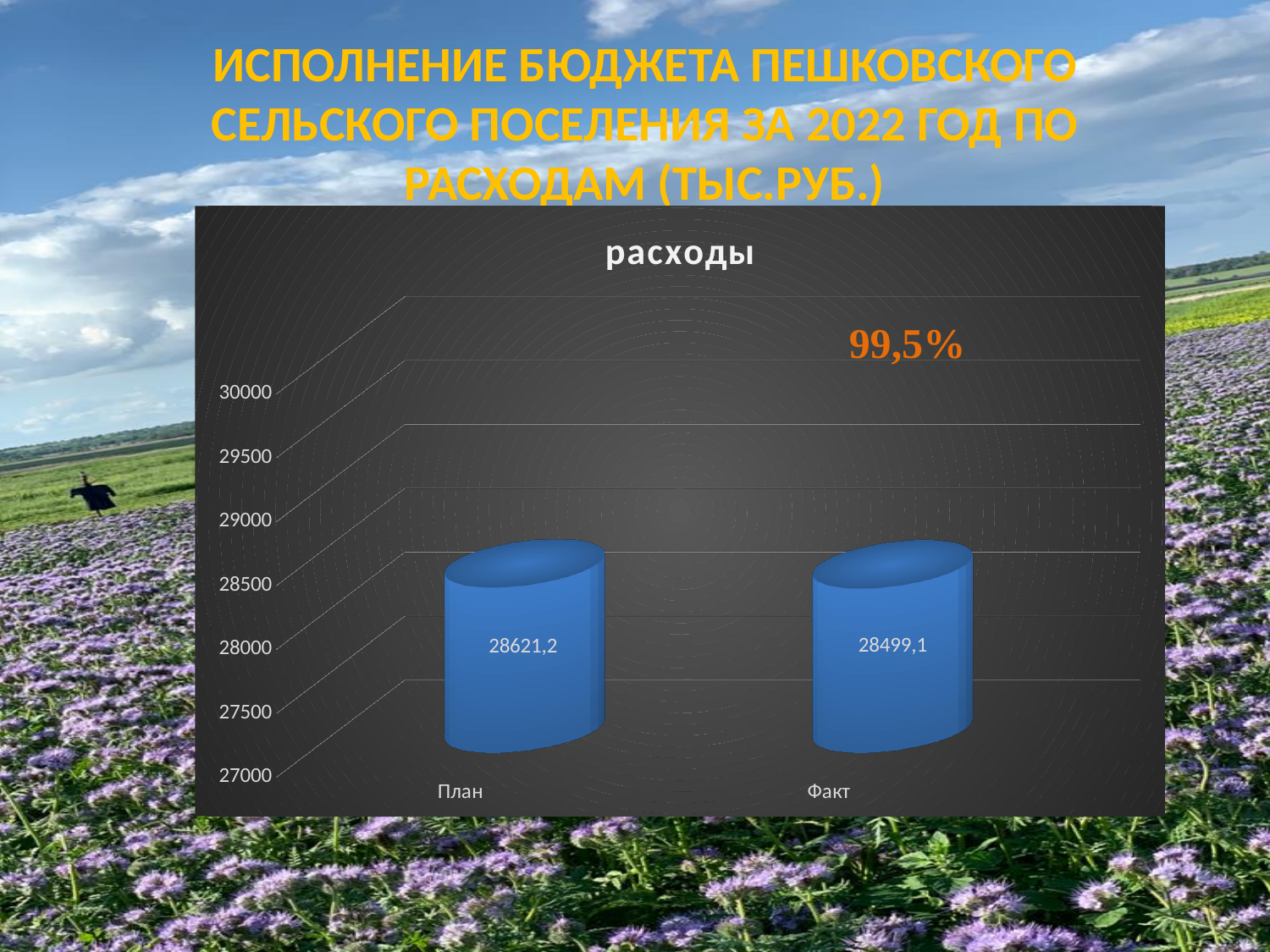
How many categories are shown on the x axis? 2 Do the values rise or fall from План to Факт? fall Which category has the lowest value? Факт Which category has the higher value, План or Факт? План What is the difference between the values for План and Факт? 122,1 What is the value for Факт? 28499,1 What is the value for План? 28621,2 Is the value for План greater or less than 28000? greater Is the value for Факт greater or less than 29000? less What kind of chart is shown on the slide? bar chart What percentage is annotated on the chart? 99,5% What is the title of the chart? расходы